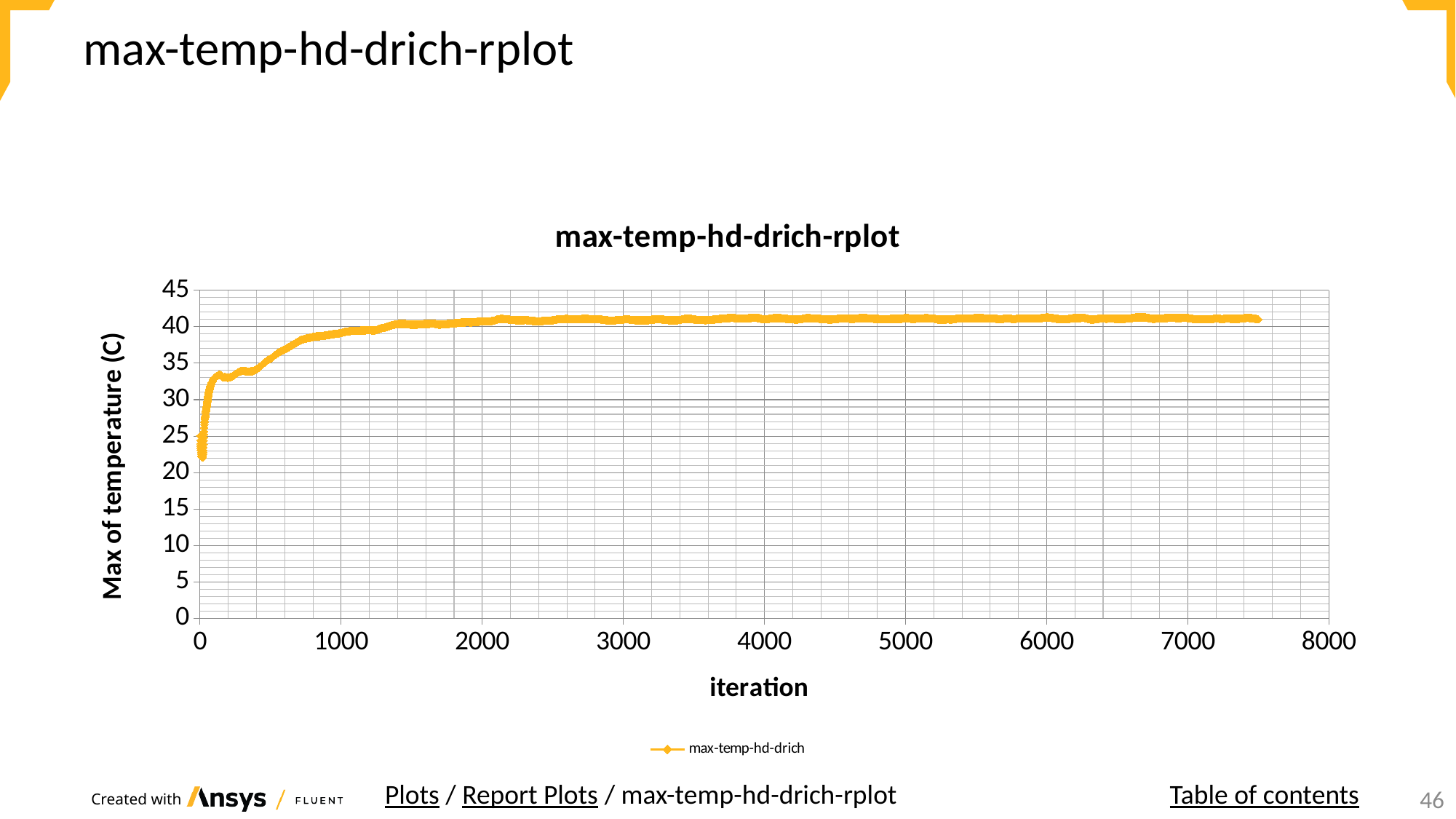
Is the value at iteration 6000 greater or less than 45? less Is the value at iteration 7000 greater or less than 40? greater Is the lowest point of the line near the start or the end of the iteration range? near the start Is the value at iteration 1000 greater or less than 35? greater What is the name of the series shown in the legend? max-temp-hd-drich How many series does the legend list? 1 What is the title of the chart? max-temp-hd-drich-rplot What kind of chart is shown on the slide? line chart Is the value at iteration 2000 larger than the value at iteration 500? yes Do the values generally rise or fall as the iteration increases from 0 to about 1500? rise